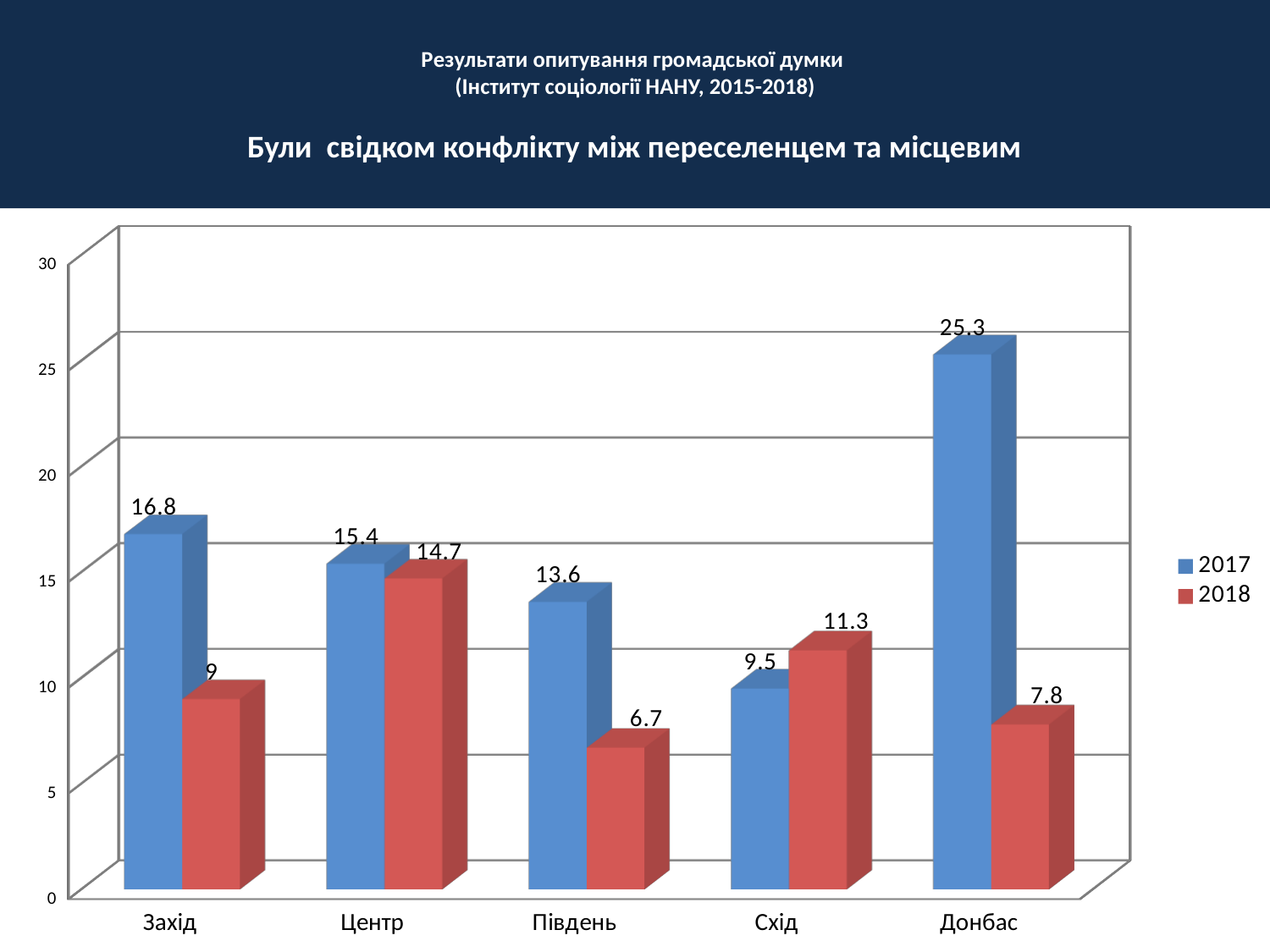
Which category has the highest value in the 2017 series? Донбас Is the 2017 value for Південь greater or less than 10? greater How many series does the legend list? 2 What is the value for Донбас in the 2017 series? 25.3 What is the value for Захід in the 2018 series? 9 What is the difference between the 2017 and 2018 values for Донбас? 17.5 What is the value for Схід in the 2018 series? 11.3 What kind of chart is shown on the slide? bar chart Which category has the lowest value in the 2018 series? Південь For Схід, which series has the larger value, 2017 or 2018? 2018 What is the difference between the 2017 values for Захід and Центр? 1.4 How many categories are shown on the x axis? 5